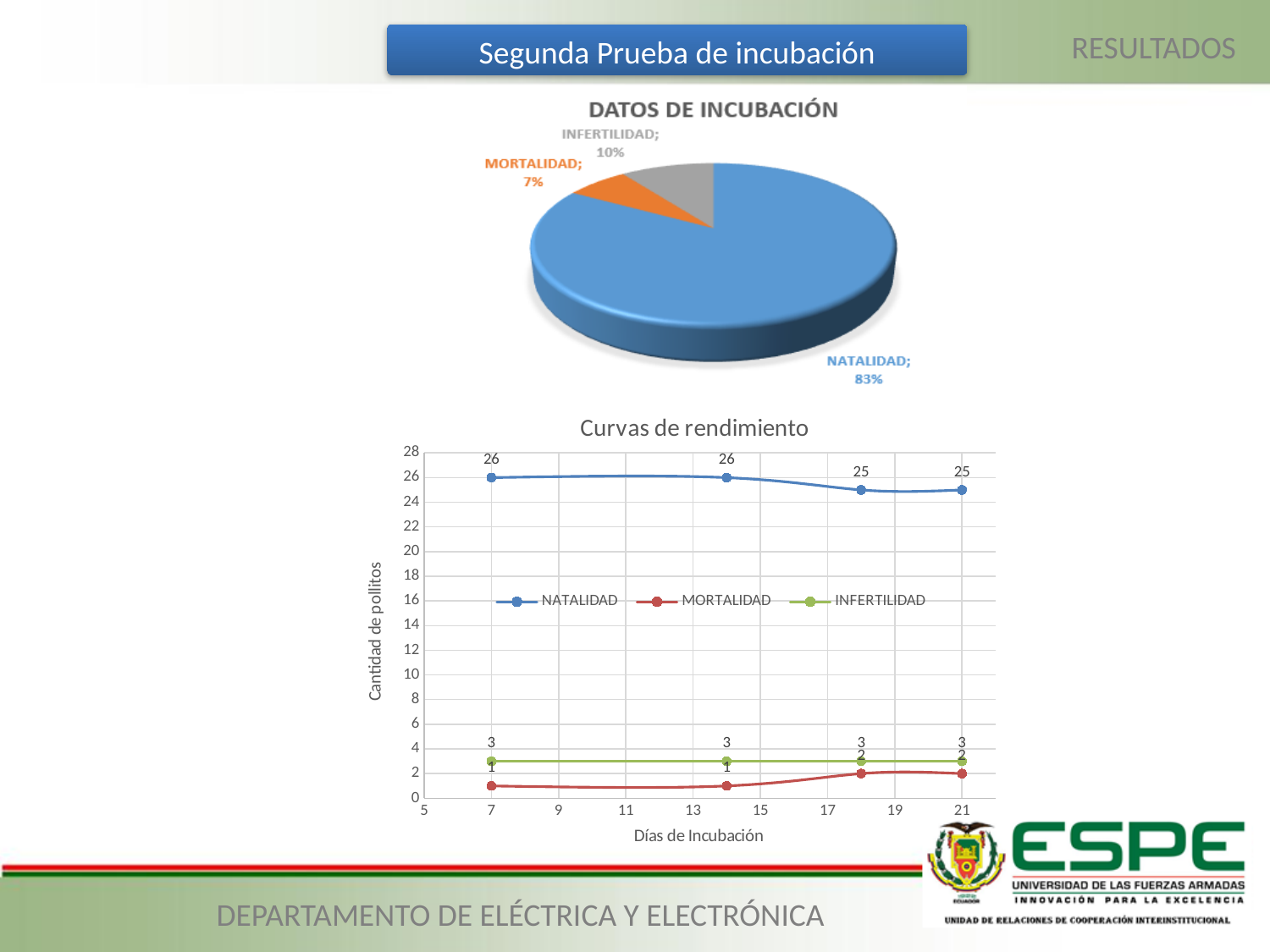
In the pie chart 'DATOS DE INCUBACIÓN', how many slices are there? 3 In the pie chart 'DATOS DE INCUBACIÓN', which category has the smallest slice? MORTALIDAD In the chart 'Curvas de rendimiento', does the NATALIDAD series rise or fall from day 7 to day 21? fall In the pie chart 'DATOS DE INCUBACIÓN', what percentage is MORTALIDAD? 7% In the pie chart 'DATOS DE INCUBACIÓN', what is the difference in percentage points between INFERTILIDAD and MORTALIDAD? 3 What kind of chart is 'Curvas de rendimiento'? line chart In the chart 'Curvas de rendimiento', what is the difference between NATALIDAD and INFERTILIDAD at day 18? 22 In the chart 'Curvas de rendimiento', what is the NATALIDAD value at day 7? 26 In the chart 'Curvas de rendimiento', what is the INFERTILIDAD value at day 14? 3 In the pie chart 'DATOS DE INCUBACIÓN', what percentage is NATALIDAD? 83% In the chart 'Curvas de rendimiento', how many series does the legend list? 3 In the chart 'Curvas de rendimiento', what is the MORTALIDAD value at day 21? 2